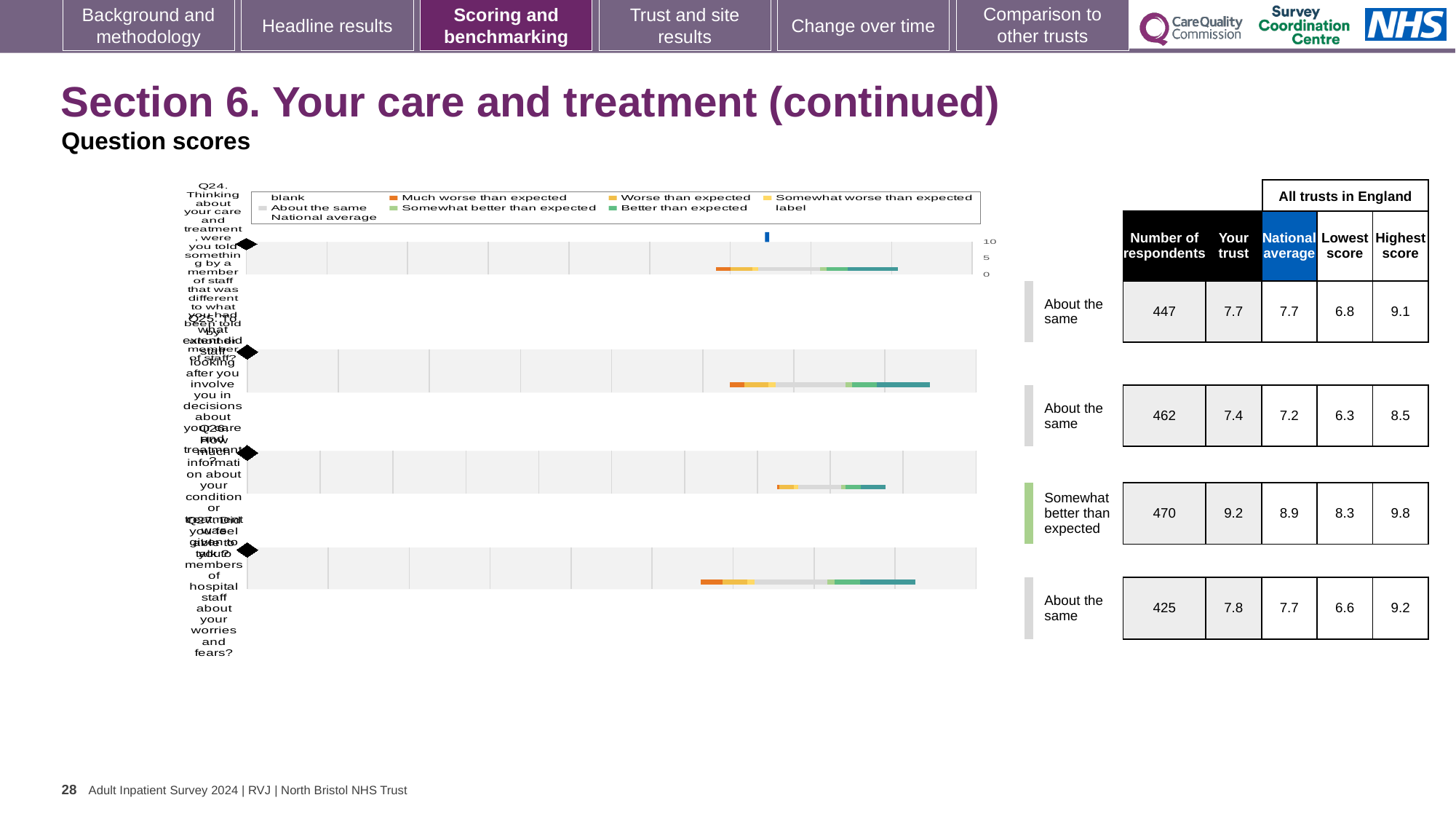
In the table beside the charts, what is the highest score across all trusts in England for Q27? 9.2 For Q26, what is the difference between the 'Your trust' score and the national average in the table beside the charts? 0.3 Which question (Q24 to Q27) has the highest 'Your trust' score in the table beside the charts? Q26 What kind of chart is used for the question scores on this slide? bar chart Which question (Q24 to Q27) has the lowest 'Your trust' score in the table beside the charts? Q25 What is the maximum value shown on the axis of the question score charts? 10 What colour represents 'Much worse than expected' in the legend of the question score charts? orange In the table beside the charts, what is the number of respondents for Q26? 470 How many question score charts (Q24 to Q27) are shown on the slide? 4 In the table beside the charts, what is the 'Your trust' score for Q24? 7.7 For Q25, which is larger in the table beside the charts: the 'Your trust' score or the national average? Your trust How many entries does the legend above the question score charts list? 9